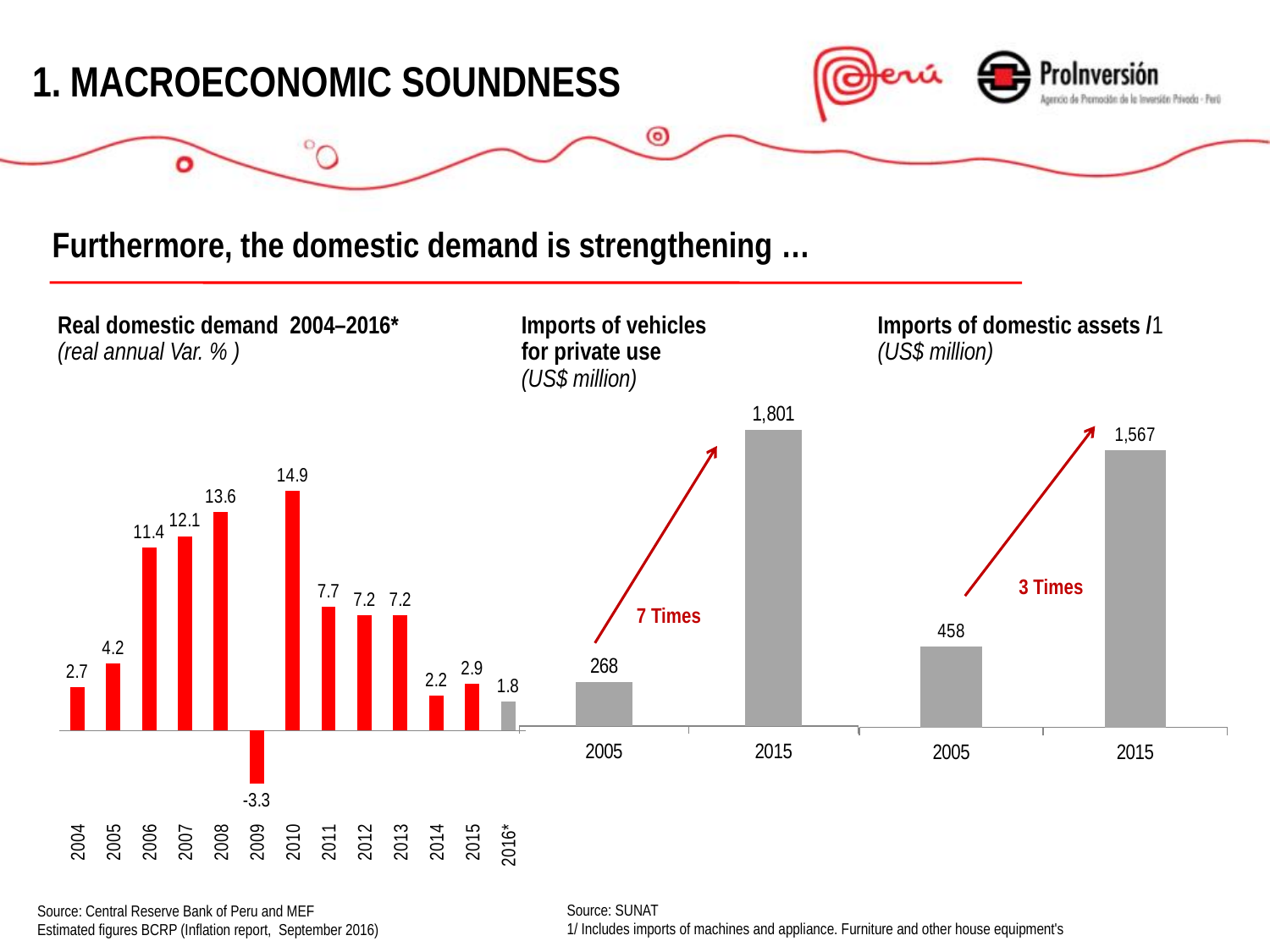
In the 'Real domestic demand 2004–2016*' chart, what is the value for 2009? -3.3 In the 'Imports of domestic assets /1' chart, what is the difference between the 2015 and 2005 values? 1,109 In the 'Imports of domestic assets /1' chart, what is the value for 2005? 458 In the 'Imports of vehicles for private use' chart, what is the value for 2015? 1,801 In the 'Real domestic demand 2004–2016*' chart, which is larger, the value for 2011 or the value for 2014? 2011 In the 'Real domestic demand 2004–2016*' chart, which year has the lowest value? 2009 In the 'Real domestic demand 2004–2016*' chart, what is the value for 2010? 14.9 In the 'Imports of vehicles for private use' chart, what is the difference between the 2015 and 2005 values? 1,533 In the 'Real domestic demand 2004–2016*' chart, how many years are plotted? 13 In the 'Real domestic demand 2004–2016*' chart, what is the difference between the values for 2008 and 2007? 1.5 In the 'Real domestic demand 2004–2016*' chart, which year has the highest value? 2010 What kind of chart is the 'Imports of domestic assets /1' chart? Bar chart